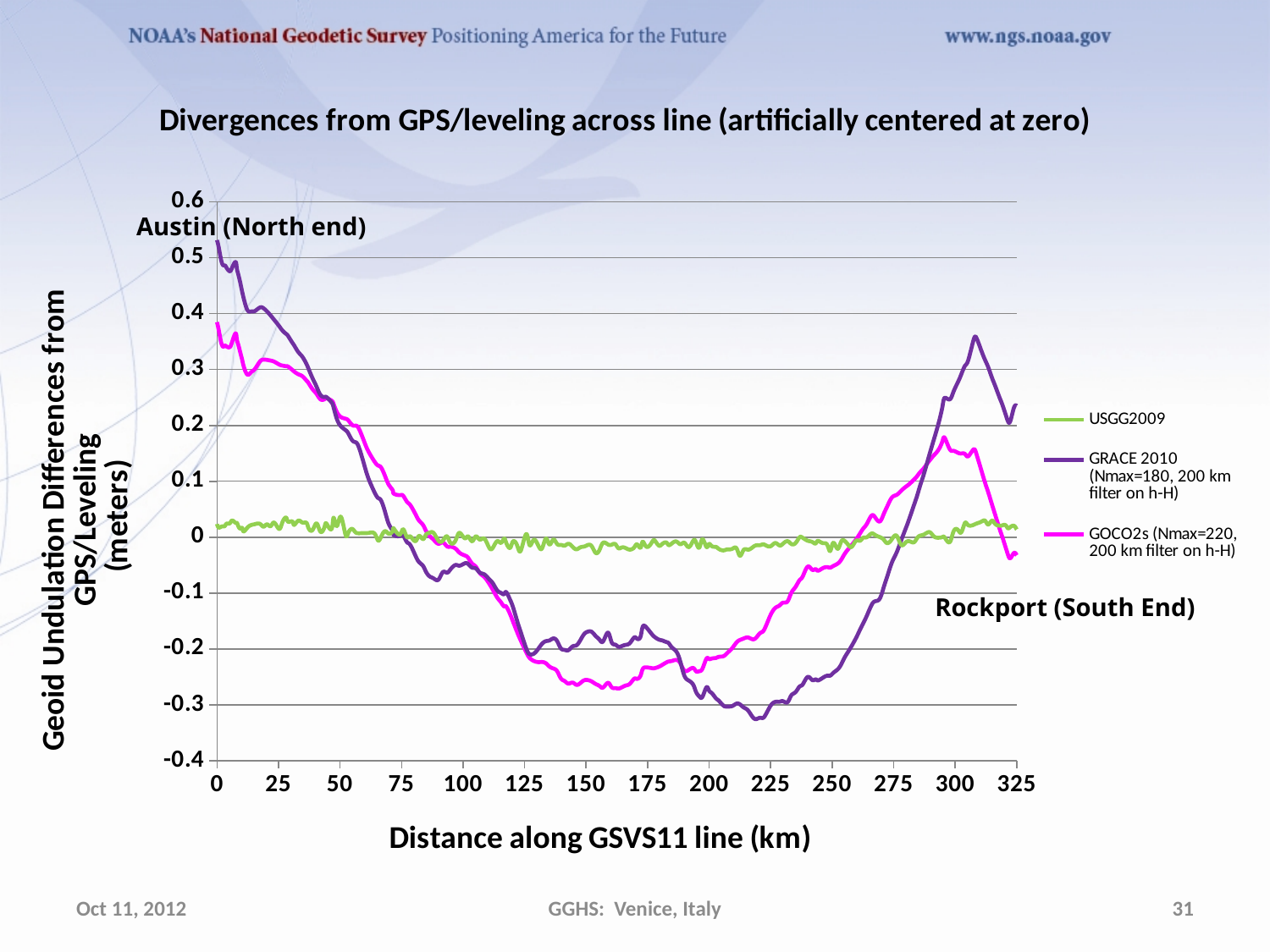
At 0 km, which series has the higher value, GRACE 2010 or GOCO2s? GRACE 2010 What kind of chart is shown on the slide? line chart What is the label of the x axis? Distance along GSVS11 line (km) Is the value of USGG2009 at 150 km greater or less than 0.1? less At 300 km, which series has the higher value, GRACE 2010 or GOCO2s? GRACE 2010 Is the value of GRACE 2010 at 0 km greater or less than 0.4? greater Which series reaches the highest value anywhere on the chart? GRACE 2010 Is the value of GRACE 2010 at 225 km greater or less than -0.2? less Does the GRACE 2010 series rise or fall between 0 km and 125 km? fall How many series does the legend list? 3 What is the title of the chart? Divergences from GPS/leveling across line (artificially centered at zero)